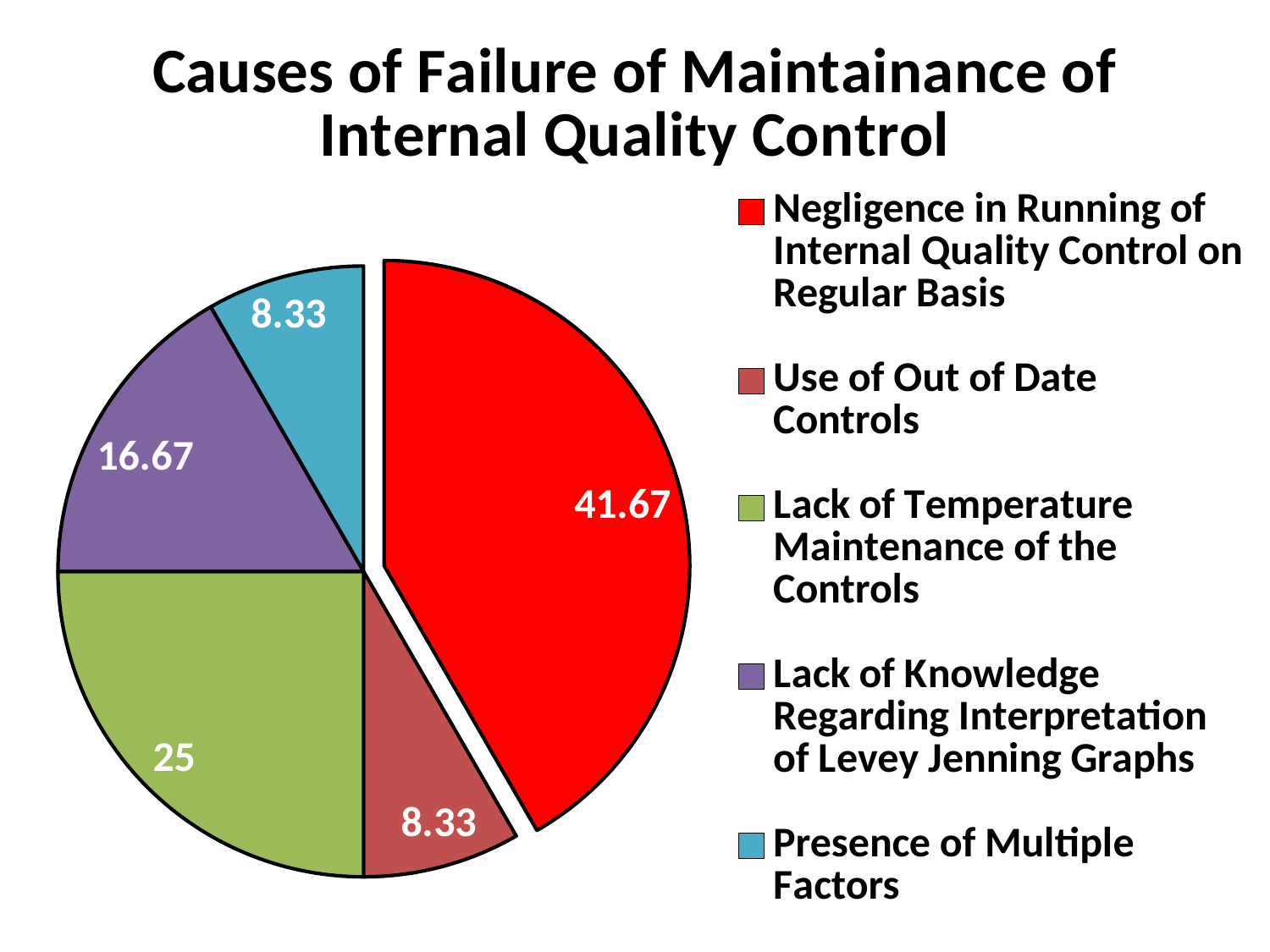
What colour is the slice for Presence of Multiple Factors? Blue What is the value for Lack of Knowledge Regarding Interpretation of Levey Jenning Graphs? 16.67 Which is larger: the value for Lack of Temperature Maintenance of the Controls or the value for Lack of Knowledge Regarding Interpretation of Levey Jenning Graphs? Lack of Temperature Maintenance of the Controls Which cause has the largest slice of the pie? Negligence in Running of Internal Quality Control on Regular Basis What is the value for Lack of Temperature Maintenance of the Controls? 25 What is the difference between the values for Negligence in Running of Internal Quality Control on Regular Basis and Lack of Temperature Maintenance of the Controls? 16.67 What is the title of the chart? Causes of Failure of Maintainance of Internal Quality Control What is the value for Use of Out of Date Controls? 8.33 How many categories does the pie chart show? 5 What is the difference between the values for Lack of Knowledge Regarding Interpretation of Levey Jenning Graphs and Presence of Multiple Factors? 8.34 What kind of chart is shown on the slide? Pie chart What is the value for Negligence in Running of Internal Quality Control on Regular Basis? 41.67